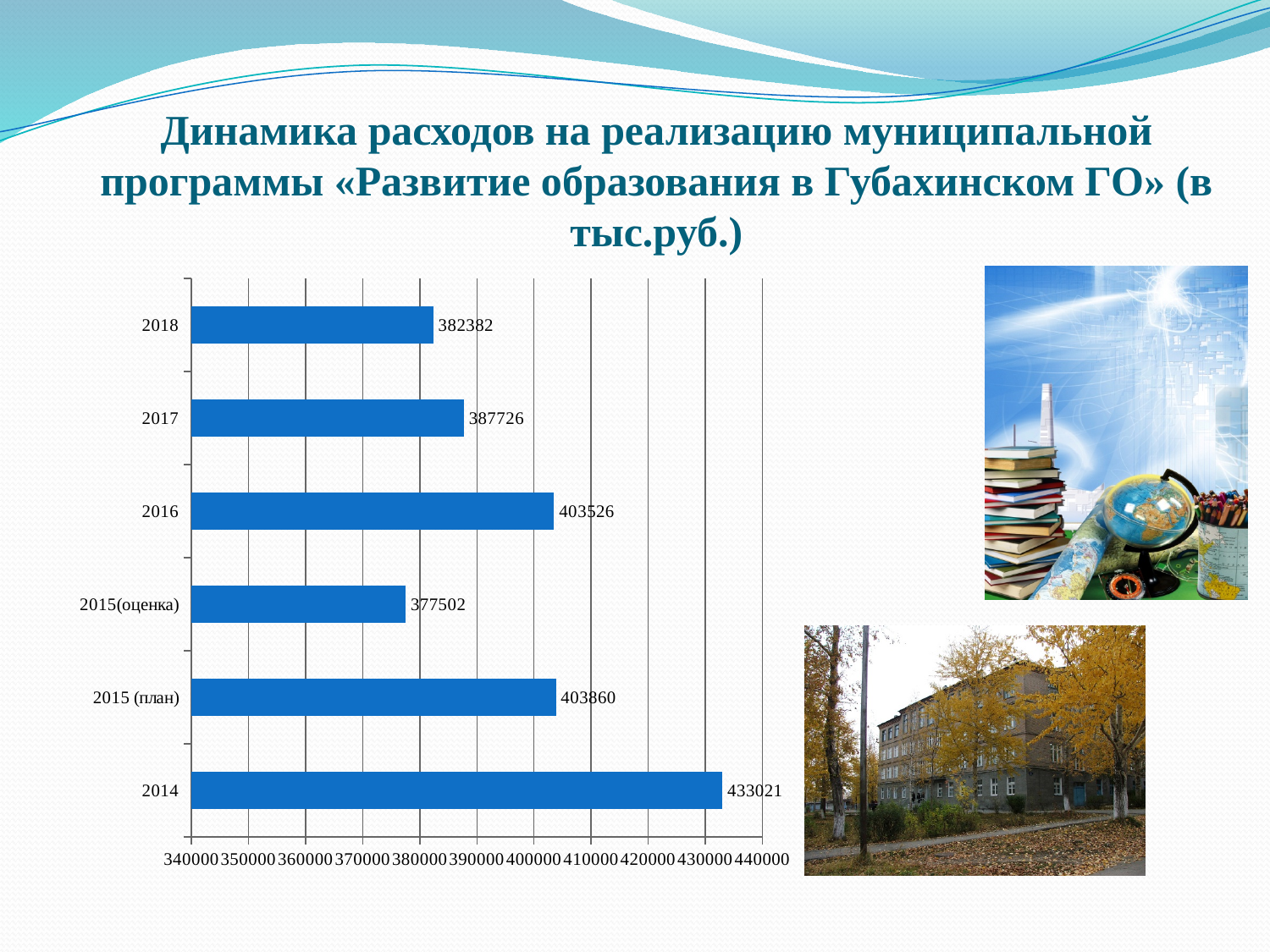
Is the value for 2016 greater or less than 400000? greater How many categories are shown in the chart? 6 What is the difference between the values for 2014 and 2018? 50639 Which category has the lowest value? 2015(оценка) What is the value for 2015(оценка)? 377502 What is the value for 2017? 387726 Which is larger, the value for 2016 or the value for 2017? 2016 What is the difference between the values for 2017 and 2018? 5344 Is the value for 2018 greater or less than 390000? less What kind of chart is shown on the slide? bar chart What is the value for 2014? 433021 Which category has the highest value? 2014